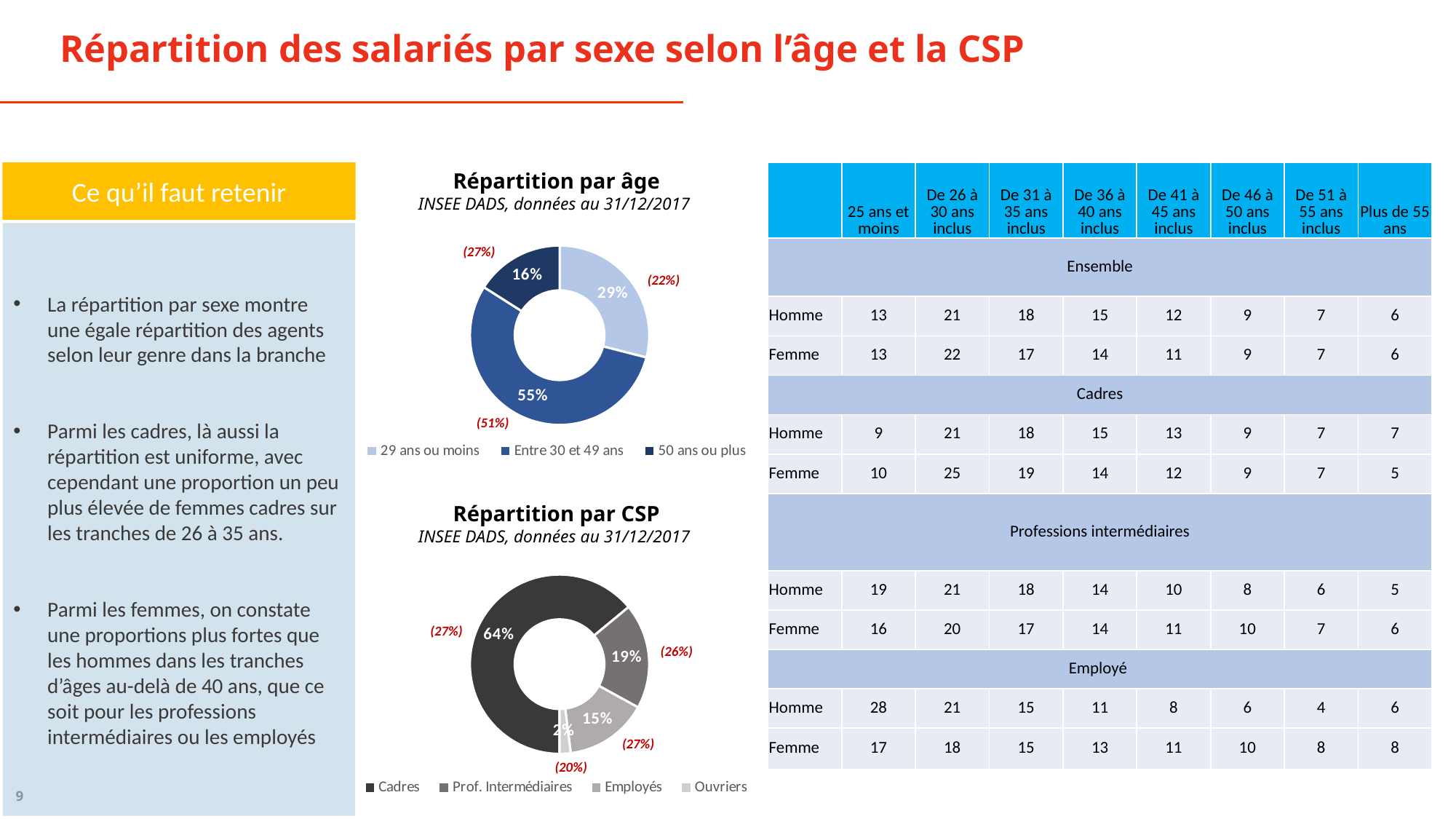
In the 'Répartition par CSP' chart, which is larger: 'Prof. Intermédiaires' or 'Employés'? Prof. Intermédiaires In the 'Répartition par âge' chart, which age group has the largest share? Entre 30 et 49 ans In the 'Répartition par CSP' chart, which category has the smallest share? Ouvriers In the 'Répartition par âge' chart, what is the difference in percentage points between 'Entre 30 et 49 ans' and '29 ans ou moins'? 26 In the 'Répartition par âge' chart, what share is shown for '29 ans ou moins'? 29% In the 'Répartition par âge' chart, what share is shown for '50 ans ou plus'? 16% In the 'Répartition par CSP' chart, what share is shown for 'Prof. Intermédiaires'? 19% In the 'Répartition par CSP' chart, what share is shown for 'Ouvriers'? 2% How many categories does the legend of the 'Répartition par CSP' chart list? 4 In the 'Répartition par âge' chart, what share is shown for 'Entre 30 et 49 ans'? 55% In the 'Répartition par âge' chart, which age group has the smallest share? 50 ans ou plus In the 'Répartition par CSP' chart, what share is shown for 'Cadres'? 64%